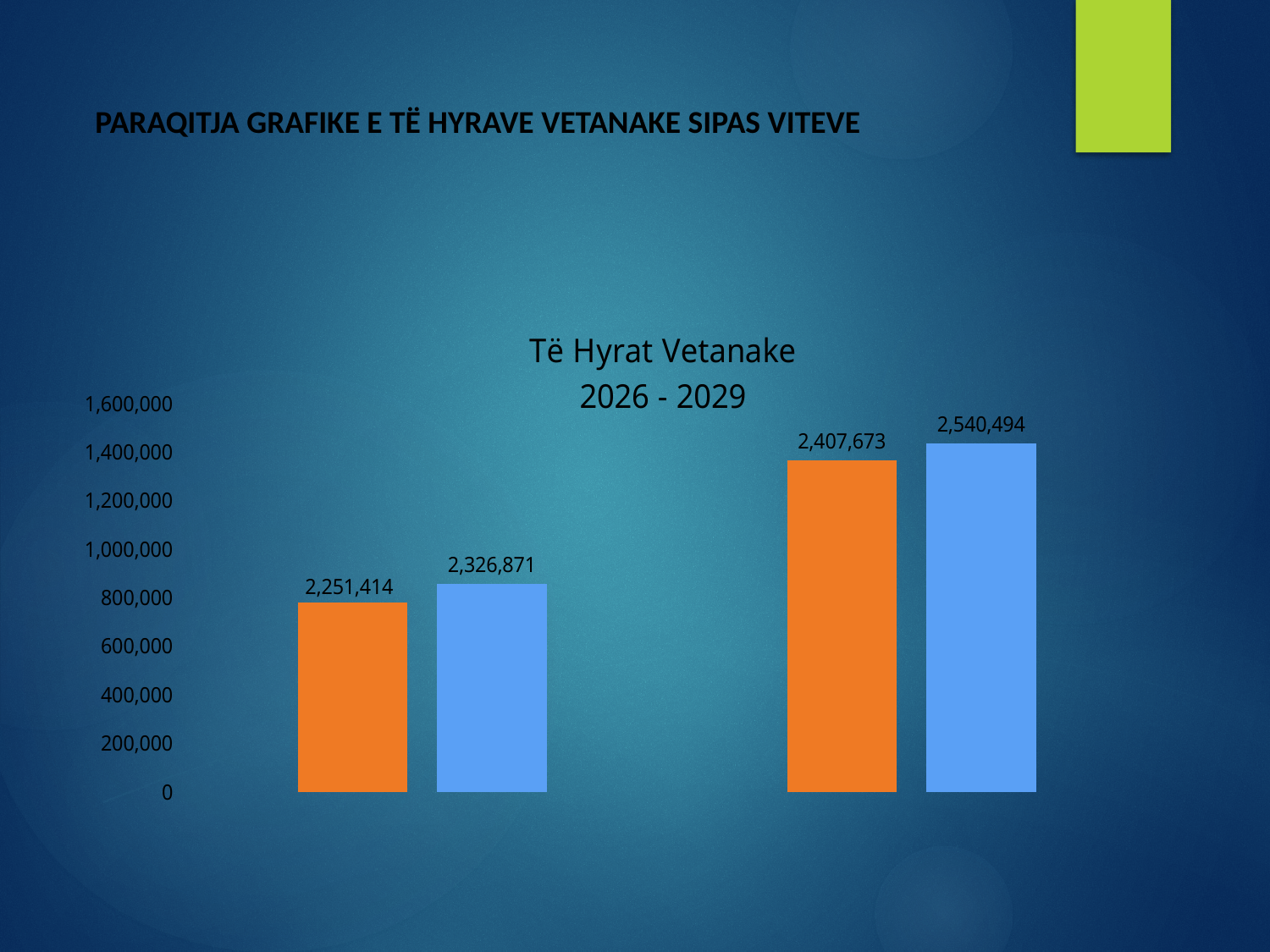
What is the value shown on the first (leftmost) bar? 2,251,414 How many bars are plotted in the chart? 4 Do the bar values rise or fall from left to right across the chart? rise What is the highest value shown in the chart? 2,540,494 What type of chart is shown on the slide? bar chart What is the title of the chart? Të Hyrat Vetanake 2026 - 2029 What is the value shown on the second bar from the left? 2,326,871 What is the value shown on the third bar from the left? 2,407,673 Which is larger, the value of the second bar from the left or the value of the third bar from the left? the third bar (2,407,673) What is the difference between the rightmost bar (2,540,494) and the leftmost bar (2,251,414)? 289,080 What is the lowest value shown in the chart? 2,251,414 What is the value shown on the rightmost bar? 2,540,494